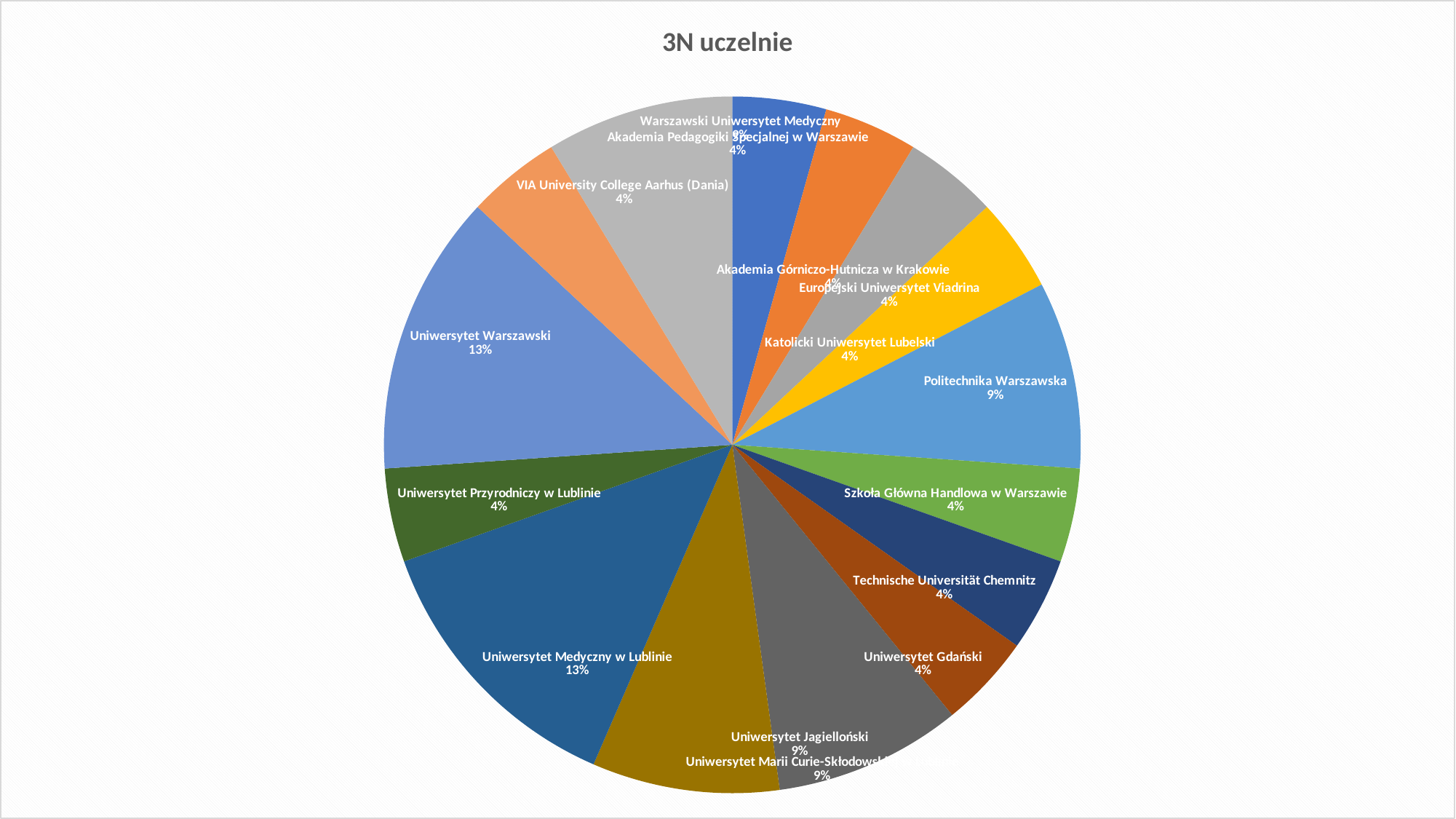
What share of the pie does Uniwersytet Jagielloński have? 9% Which is larger, the share for Uniwersytet Warszawski or the share for Uniwersytet Jagielloński? Uniwersytet Warszawski What is the title of the chart? 3N uczelnie What share of the pie does VIA University College Aarhus (Dania) have? 4% What is the difference in percentage points between the share for Uniwersytet Medyczny w Lublinie and the share for Szkoła Główna Handlowa w Warszawie? 9 What kind of chart is shown on the slide? pie chart Which is larger, the share for Politechnika Warszawska or the share for Uniwersytet Gdański? Politechnika Warszawska What share of the pie does Technische Universität Chemnitz have? 4% What share of the pie does Uniwersytet Warszawski have? 13% How many slices does the pie chart have? 15 What share of the pie does Politechnika Warszawska have? 9% What share of the pie does Uniwersytet Medyczny w Lublinie have? 13%